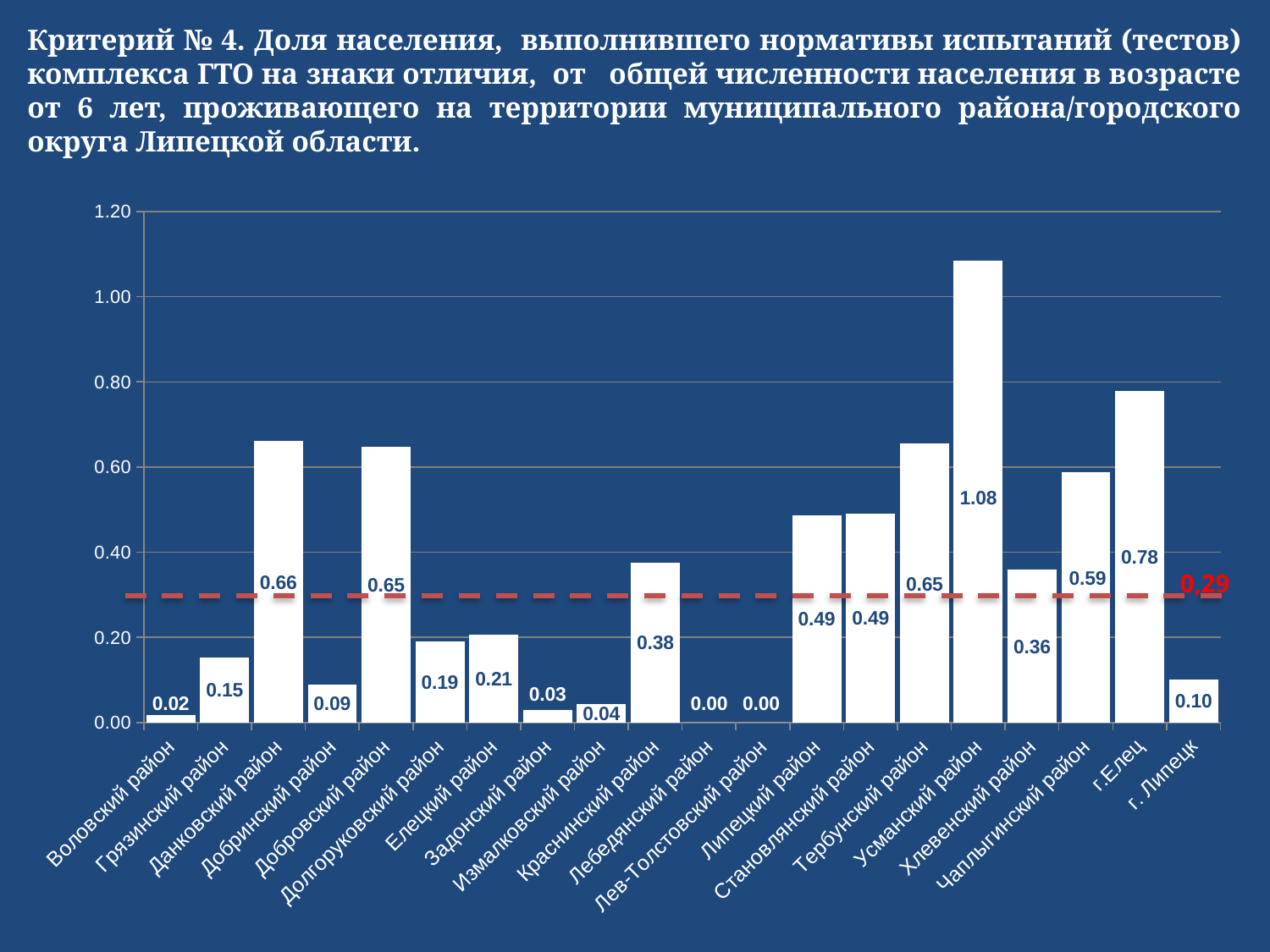
Which is larger, the value for Чаплыгинский район or the value for Хлевенский район? Чаплыгинский район What is the value for г. Липецк? 0.10 Which category has the highest value? Усманский район What value is marked by the red dashed horizontal line? 0.29 What is the value for Краснинский район? 0.38 What is the difference between the values for Данковский район and Грязинский район? 0.51 What is the difference between the values for Усманский район and г.Елец? 0.30 How many categories are shown on the x axis? 20 What is the value for Усманский район? 1.08 Which two categories have a value of 0.00? Лебедянский район and Лев-Толстовский район What is the value for г.Елец? 0.78 What kind of chart is shown on the slide? Bar chart